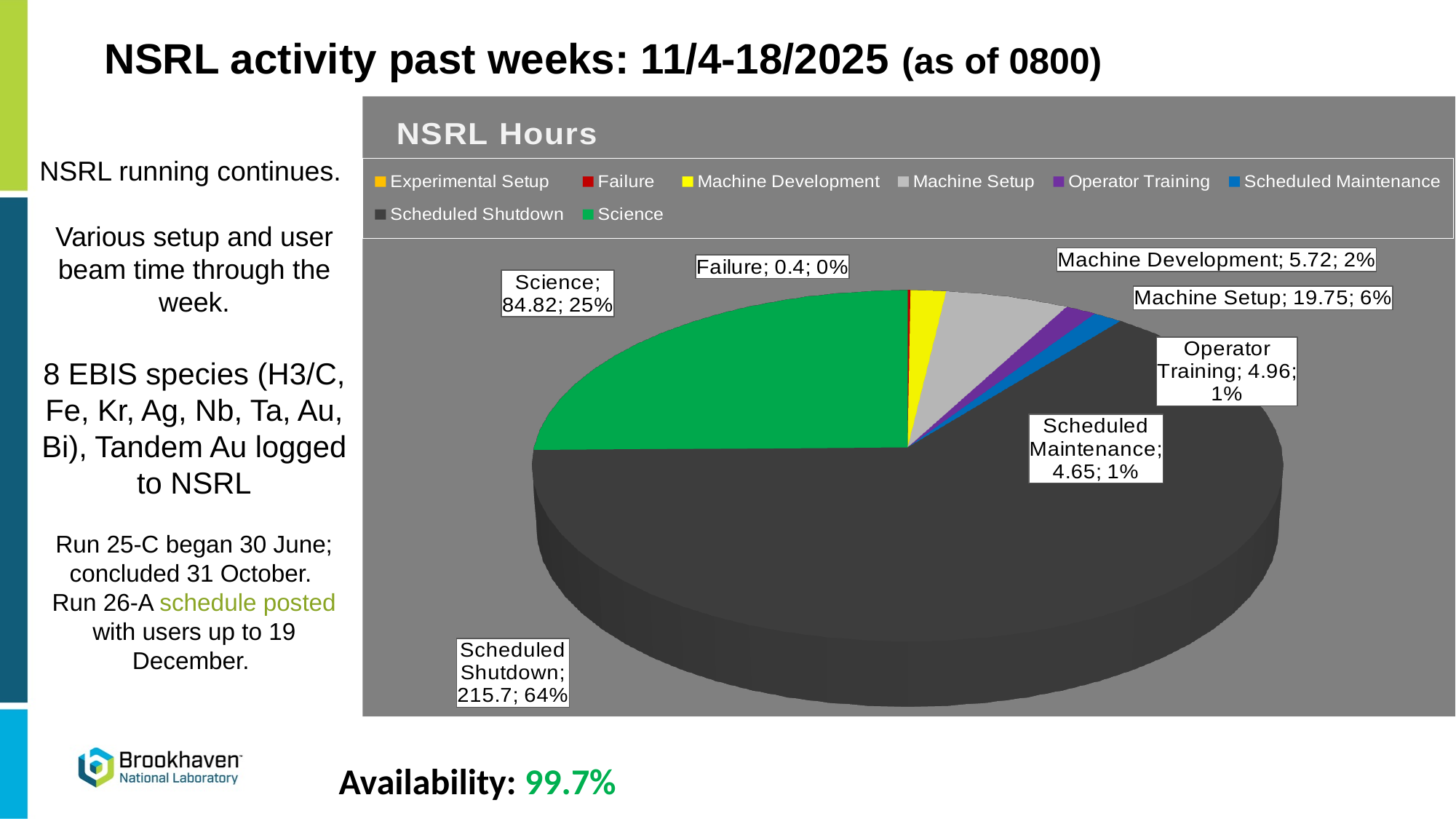
Which is larger, Machine Setup or Machine Development? Machine Setup What is the title of the chart? NSRL Hours What share of the pie does Science account for? 25% What kind of chart is the NSRL Hours chart? pie chart What value is shown for Machine Setup? 19.75 How many hours are shown for Scheduled Shutdown? 215.7 Which category has the largest slice in the NSRL Hours chart? Scheduled Shutdown How many categories does the legend of the NSRL Hours chart list? 8 What value is shown for Failure? 0.4 What is the difference in hours between Scheduled Shutdown and Science? 130.88 What share of the pie does Scheduled Shutdown account for? 64% How many hours are shown for Science in the NSRL Hours chart? 84.82